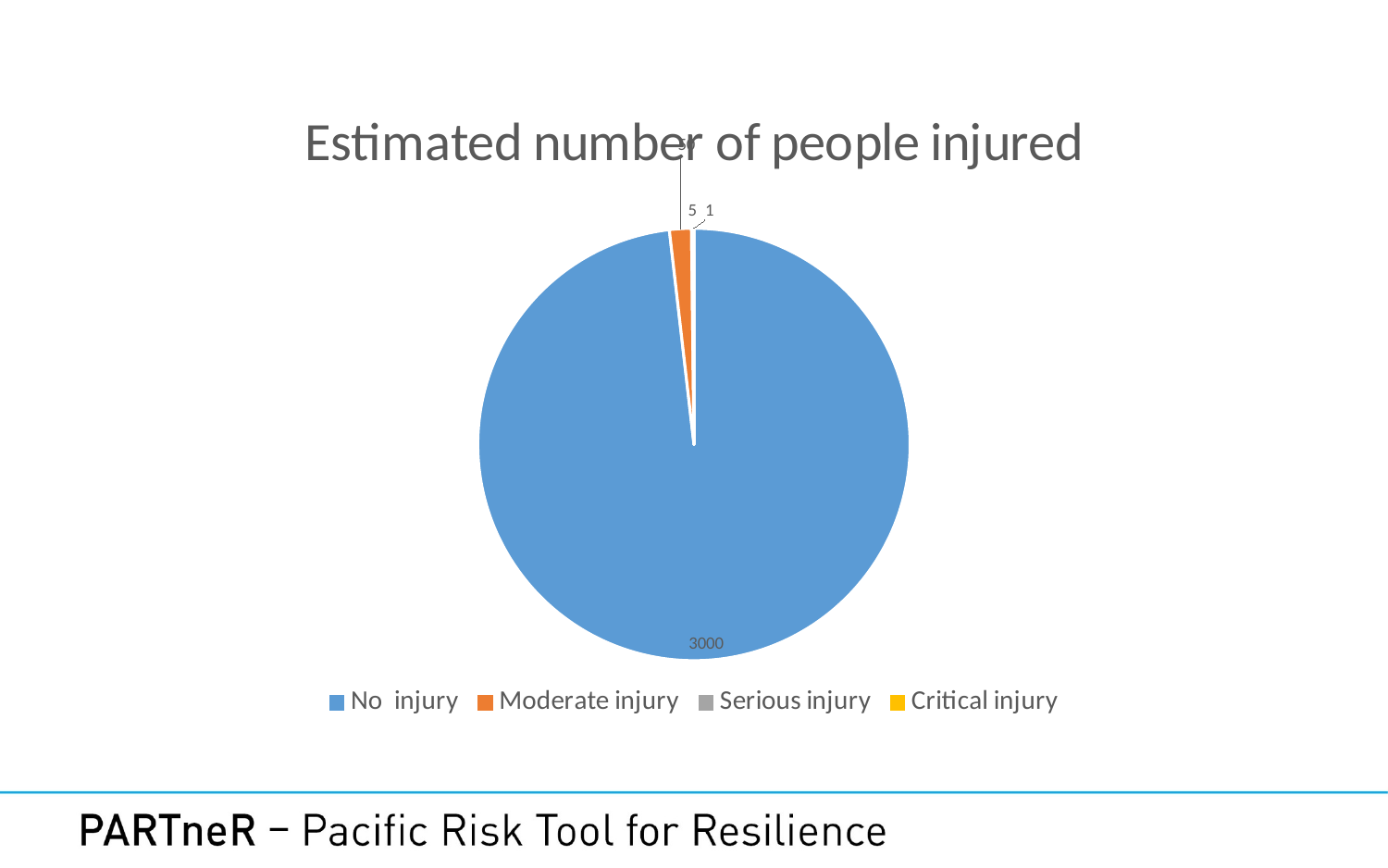
What is the estimated number of people with no injury? 3000 Which is larger, the number of people with no injury or with moderate injury? No injury Which injury category has the largest slice of the pie? No injury What colour represents the 'No injury' category in the chart? Blue What kind of chart is shown on the slide? Pie chart What is the title of the chart? Estimated number of people injured Which is larger, the number of people with moderate injury or with serious injury? Moderate injury What is the estimated number of people with serious injury? 5 How many injury categories does the legend list? 4